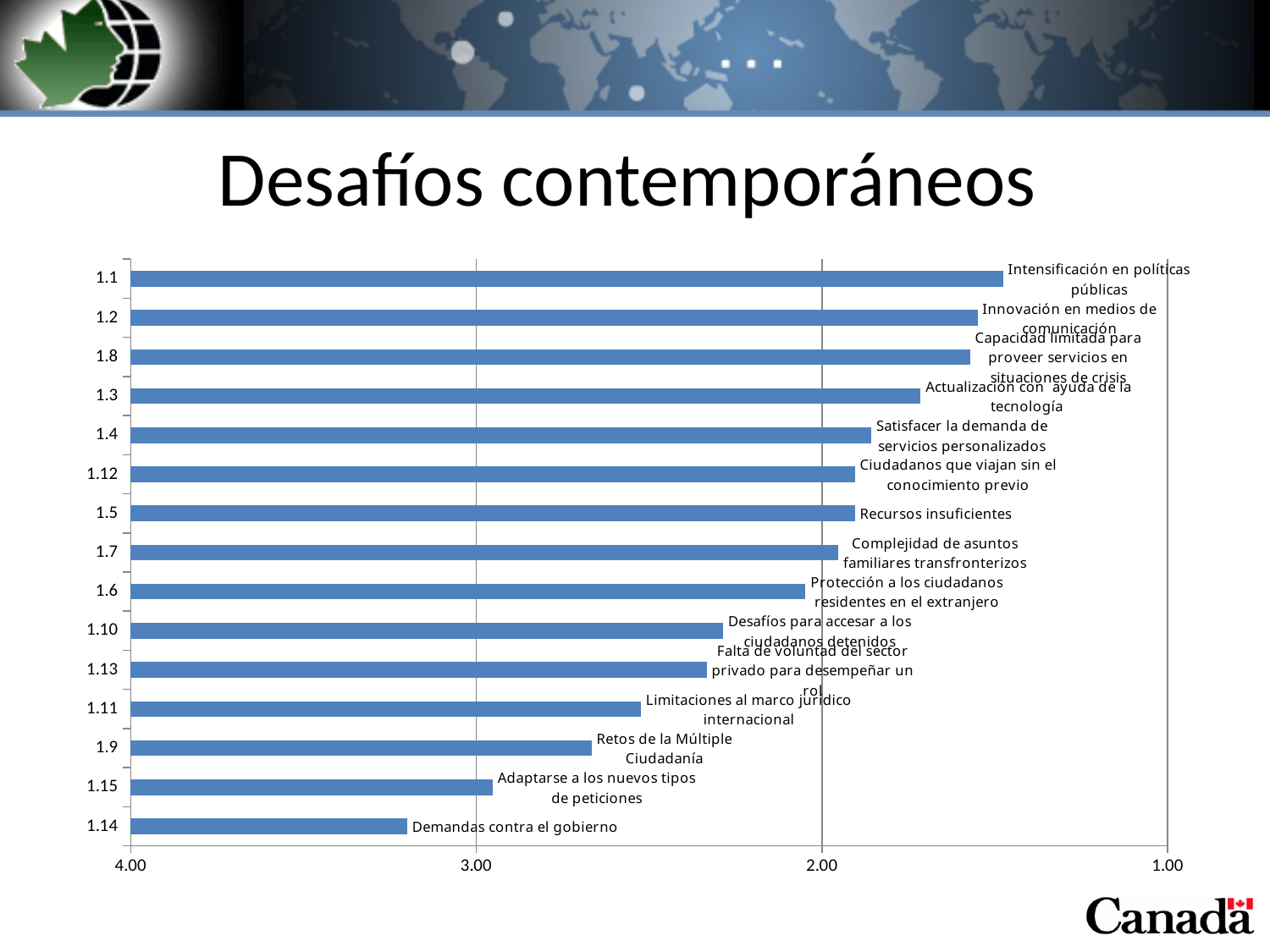
Going from the top bar to the bottom bar, do the bars get longer or shorter? shorter Which category has the longest bar in the chart? 1.1 (Intensificación en políticas públicas) Which category has the shortest bar in the chart? 1.14 (Demandas contra el gobierno) What kind of chart is shown on the slide? bar chart Which bar is longer, the one for 1.9 or the one for 1.15? 1.9 Is the value for 1.14 (Demandas contra el gobierno) greater or less than 3.00? greater Which bar is longer, the one for 1.2 or the one for 1.3? 1.2 Is the value for 1.1 (Intensificación en políticas públicas) greater or less than 2.00? less What value is shown at the left end of the x axis? 4.00 How many bars (categories) does the chart show? 15 What is the title of the slide's chart? Desafíos contemporáneos What label is attached to the bar for category 1.5? Recursos insuficientes